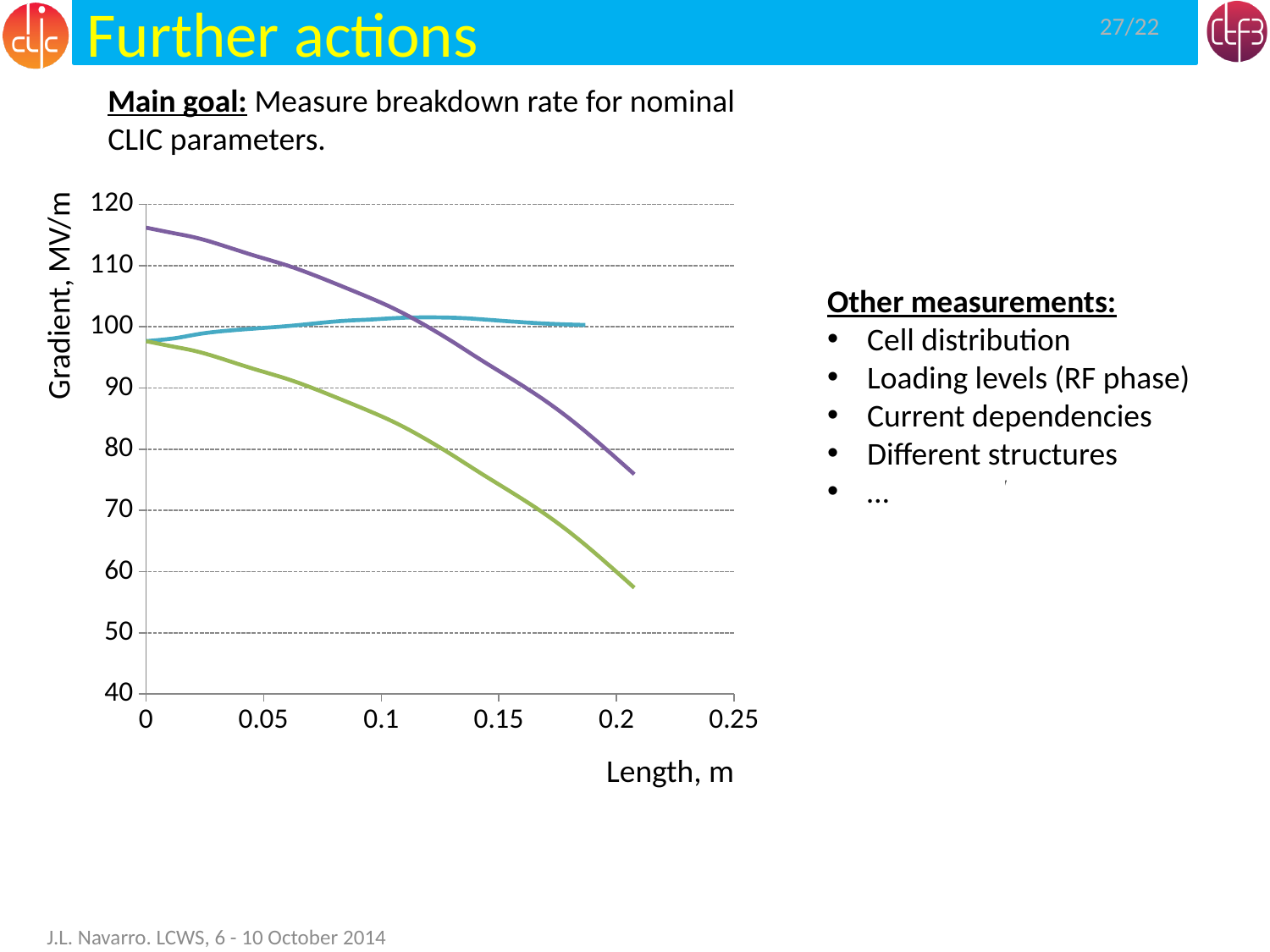
What is the label of the horizontal axis of the chart? Length, m What is the label of the vertical axis of the chart? Gradient, MV/m Is the value of the green line at length 0.15 greater or less than 80? less Does the purple line rise or fall as length increases? fall At length 0.2, which is larger: the purple line or the green line? the purple line Which line has the highest value at length 0? the purple line Which line has the lowest value at length 0.2? the green line What kind of chart is shown on the slide? line chart How many lines are plotted on the chart? 3 Is the value of the purple line at length 0 greater or less than 110? greater Is the value of the purple line at length 0.15 greater or less than 90? greater Does the green line rise or fall as length increases? fall